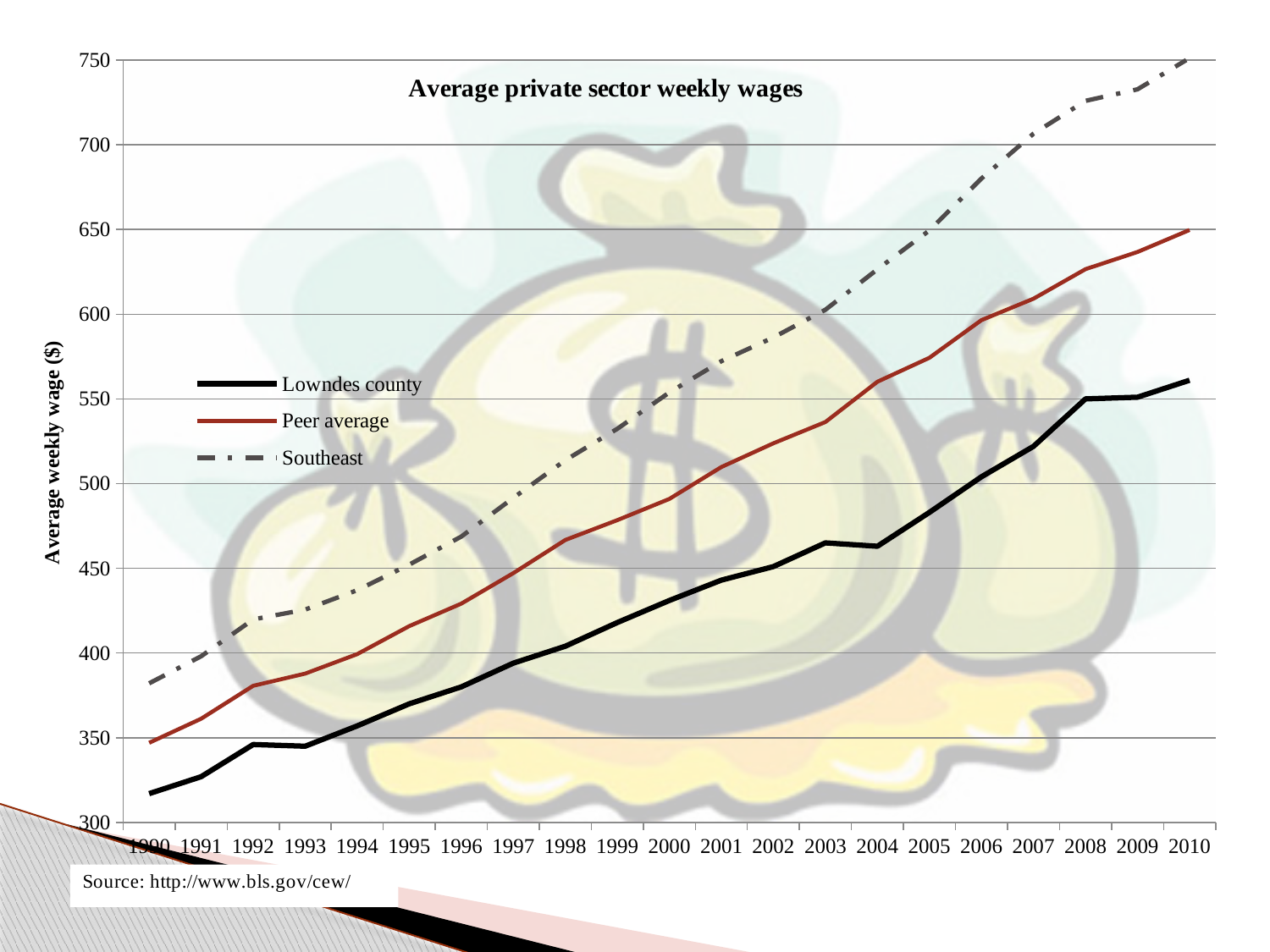
What kind of chart is shown on the slide? line chart Is the value for Peer average in 2008 greater or less than 600? greater Do the Lowndes county values generally rise or fall from 1990 to 2010? rise Which series has the highest value in 2010? Southeast What is the title of the chart? Average private sector weekly wages Which series has the lowest value in 2010? Lowndes county In 2005, which is larger: the Southeast value or the Lowndes county value? Southeast Is the value for Lowndes county in 2010 greater or less than 550? greater Is the value for Lowndes county in 1990 greater or less than 350? less How many years are plotted along the x axis? 21 How many series does the legend list? 3